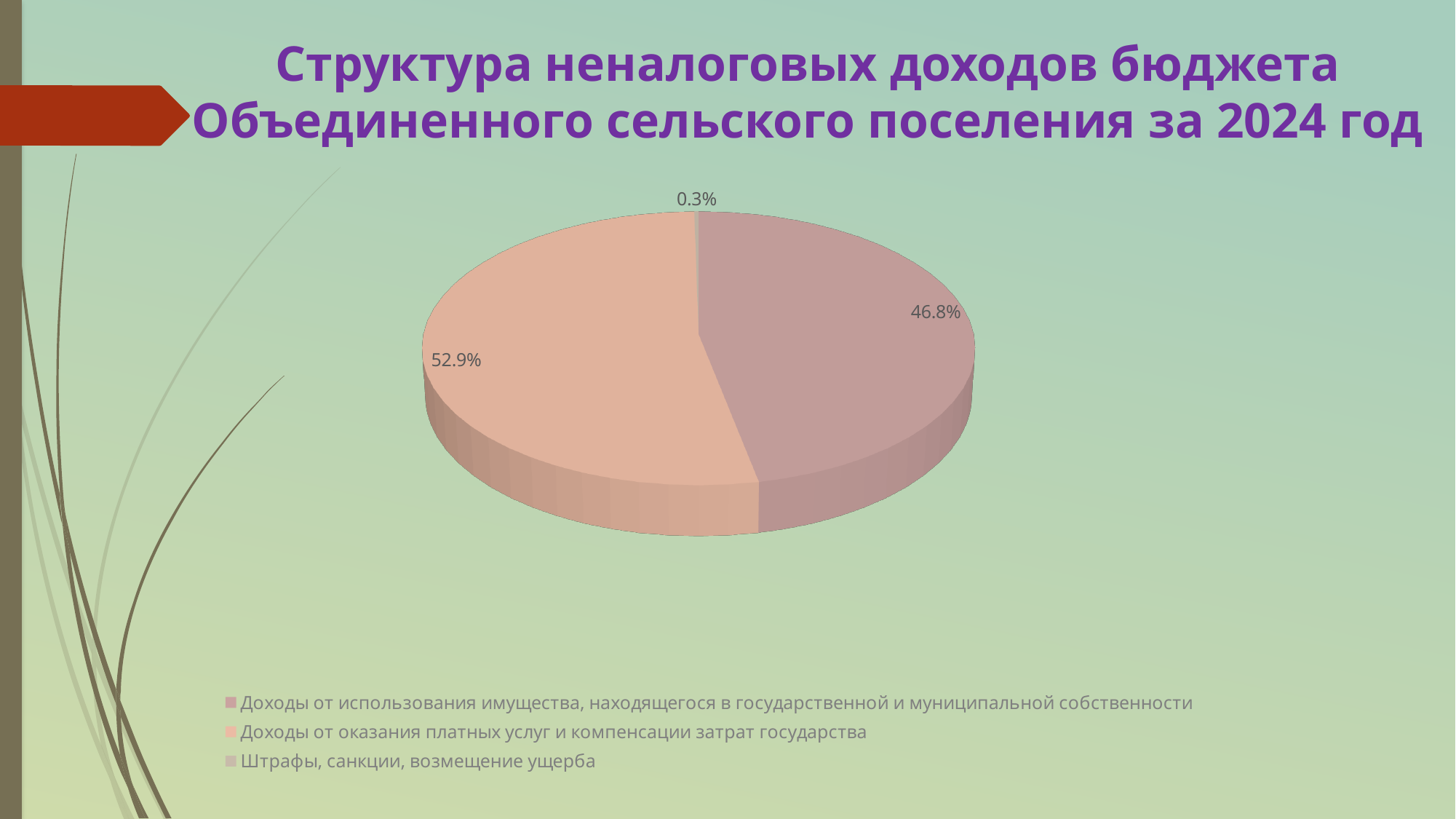
What is the share of "Штрафы, санкции, возмещение ущерба" in the pie chart? 0.3% What is the difference in percentage points between the share of "Доходы от оказания платных услуг и компенсации затрат государства" and "Доходы от использования имущества, находящегося в государственной и муниципальной собственности"? 6.1 percentage points What is the share of "Доходы от использования имущества, находящегося в государственной и муниципальной собственности" in the pie chart? 46.8% What kind of chart is shown on the slide? Pie chart Which category has the largest slice of the pie chart? Доходы от оказания платных услуг и компенсации затрат государства Which legend entry is shown in the peach colour? Доходы от оказания платных услуг и компенсации затрат государства Which is larger: the share of "Доходы от использования имущества, находящегося в государственной и муниципальной собственности" or the share of "Штрафы, санкции, возмещение ущерба"? Доходы от использования имущества, находящегося в государственной и муниципальной собственности Which category has the smallest slice of the pie chart? Штрафы, санкции, возмещение ущерба What is the title of the chart on the slide? Структура неналоговых доходов бюджета Объединенного сельского поселения за 2024 год What is the share of "Доходы от оказания платных услуг и компенсации затрат государства" in the pie chart? 52.9% How many entries does the legend list? 3 How many categories does the pie chart show? 3